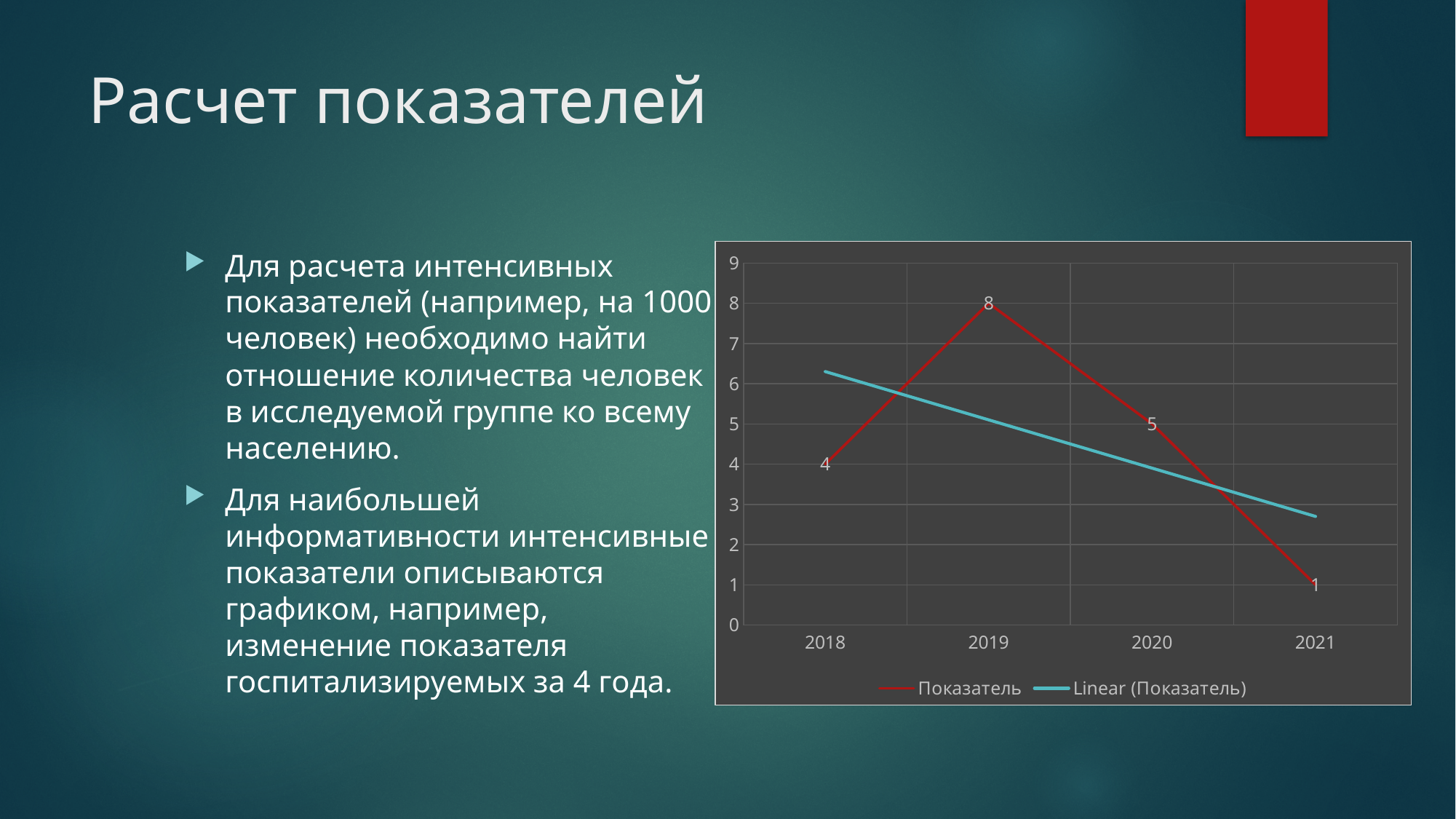
Does the Показатель line rise or fall from 2019 to 2021? fall What is the value of Показатель for 2019? 8 Which year has the highest value of Показатель? 2019 Is the value of the Linear (Показатель) trendline at 2018 greater or less than 5? greater What is the difference between the Показатель values for 2019 and 2020? 3 Which year has the lowest value of Показатель? 2021 How many entries does the legend list? 2 How many years are shown on the x axis? 4 Which is larger, the Показатель value for 2018 or for 2020? 2020 What kind of chart is shown? line chart What is the value of Показатель for 2018? 4 What is the value of Показатель for 2021? 1